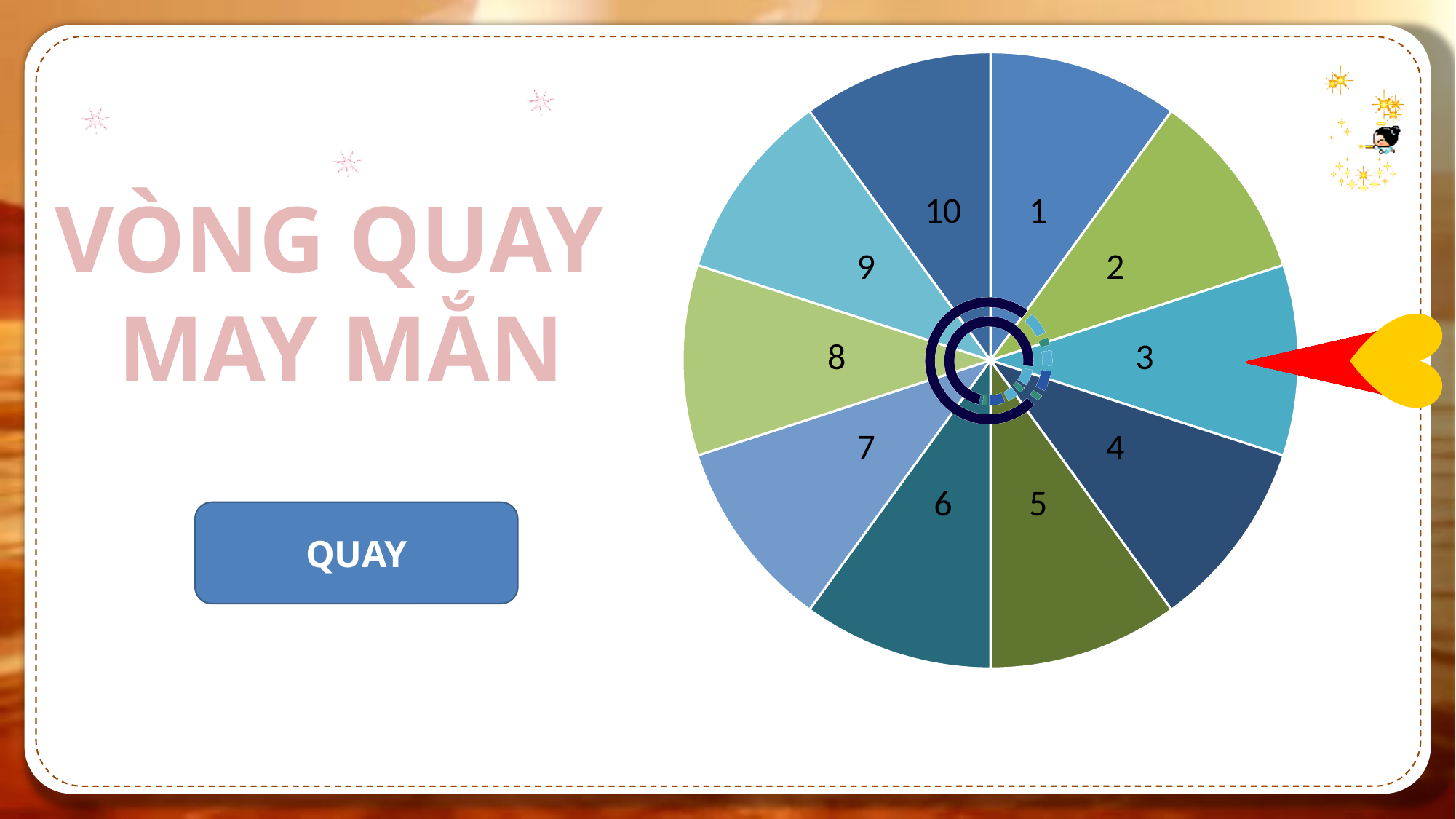
What is the lowest number labelled on the wheel? 1 Which slice label is directly opposite slice 3 on the wheel? 8 Which slice label is next to slice 10 going clockwise? 1 What is the label of the slice the red arrow points to? 3 What kind of chart is the wheel on the slide? pie chart How many slices does the wheel have? 10 What is the title shown on the left of the slide? VÒNG QUAY MAY MẮN What is the highest number labelled on the wheel? 10 Which slice label sits between slices 4 and 6 on the wheel? 5